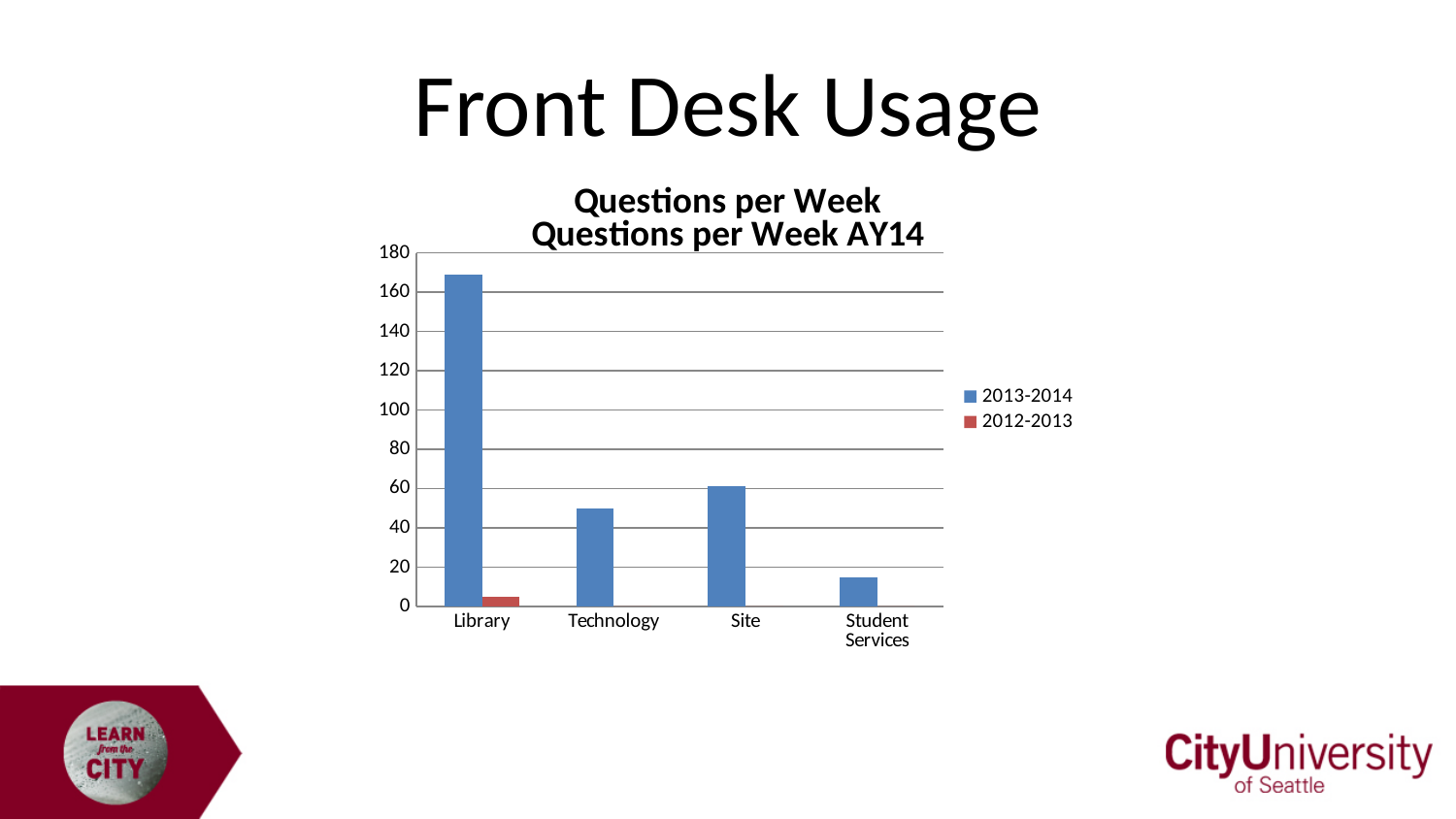
Is the 2013-2014 value for Library greater or less than 160? greater What is the title of the chart? Questions per Week How many categories are shown on the x axis? 4 Is the 2013-2014 value for Student Services greater or less than 20? less Is the 2012-2013 value for Library greater or less than 20? less What kind of chart is shown on the slide? bar chart Which has the larger 2013-2014 value, Site or Technology? Site How many series does the legend list? 2 Which category has the lowest value for 2013-2014? Student Services Which series is shown in blue? 2013-2014 Which category has the highest value for 2013-2014? Library